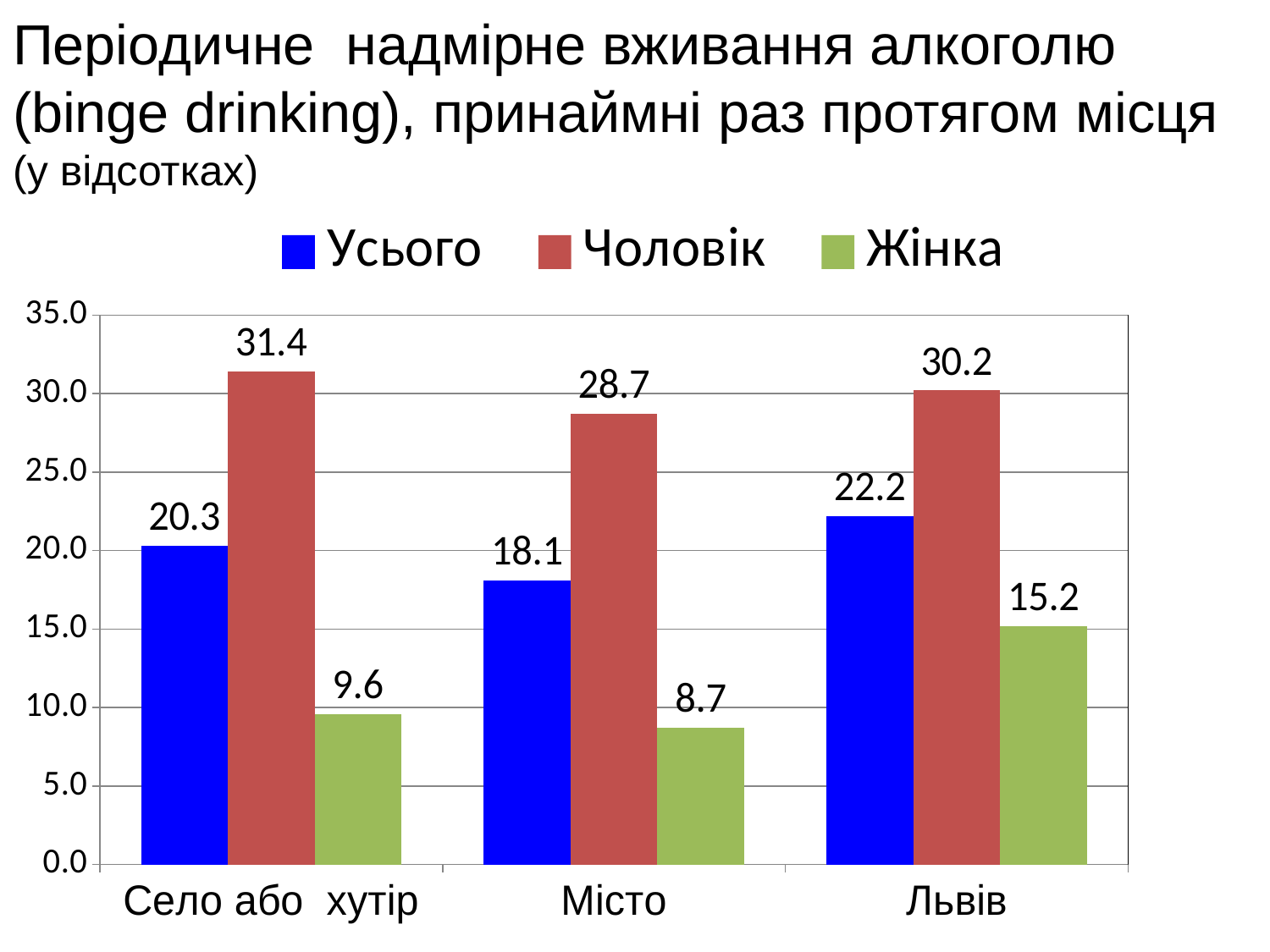
How many categories are shown on the x axis? 3 What is the value for Чоловік in Село або хутір? 31.4 What is the value for Усього in Львів? 22.2 Which category has the lowest value for Усього? Місто What is the value for Жінка in Місто? 8.7 Which is larger: the Чоловік value in Село або хутір or in Місто? Село або хутір What kind of chart is shown on the slide? bar chart Which colour represents the Жінка series? green How many series does the legend list? 3 Is the value for Усього in Село або хутір greater or less than 20.0? greater Which category has the highest value for Жінка? Львів What is the difference between the Чоловік and Жінка values in Львів? 15.0